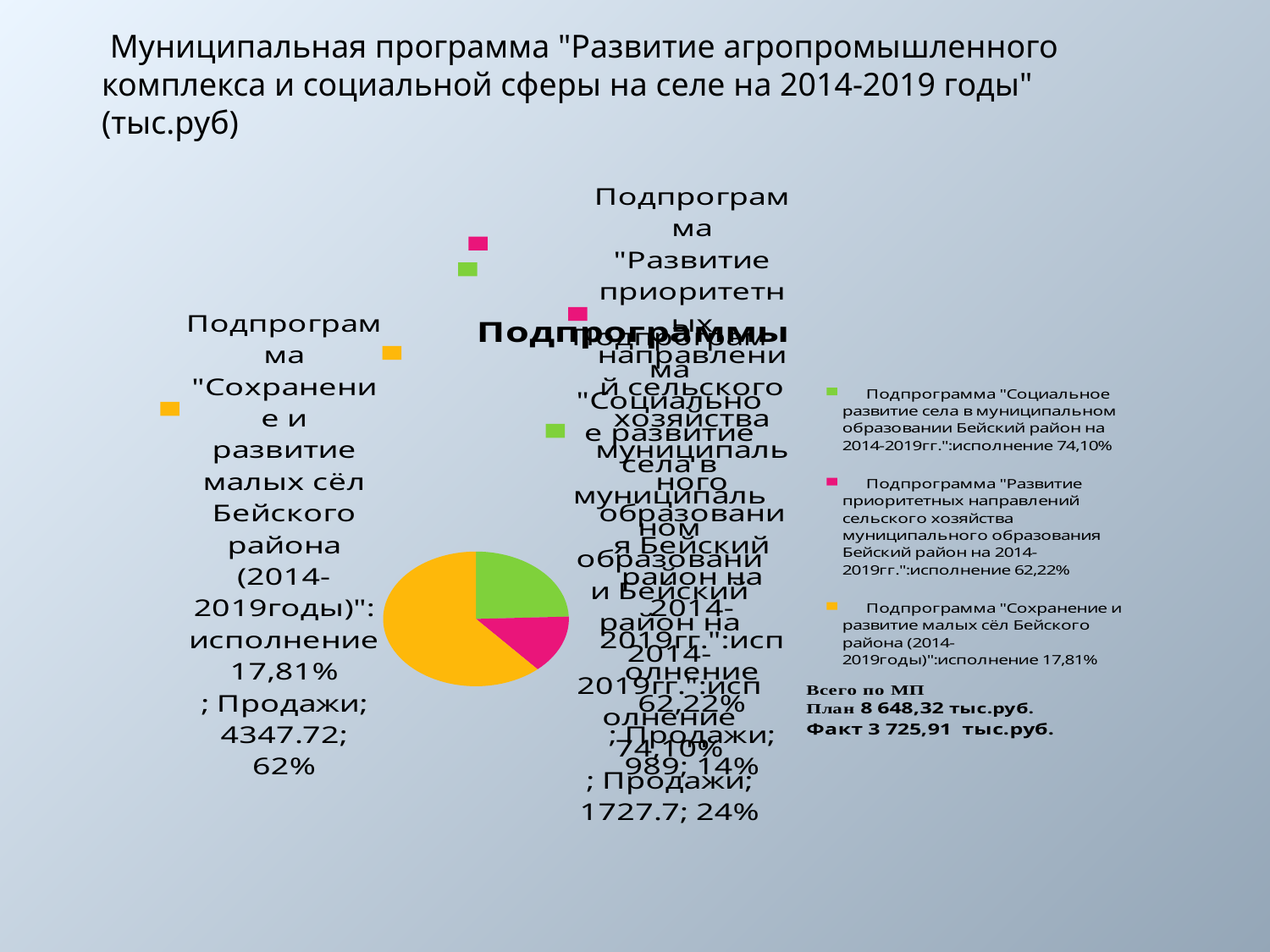
Which subprogram has the largest slice of the pie? Сохранение и развитие малых сёл Бейского района What kind of chart is shown on the slide? Pie chart What is the title of the pie chart? Подпрограммы What share of the pie does the subprogram "Развитие приоритетных направлений сельского хозяйства" take? 14% Which subprogram has the smallest slice of the pie? Развитие приоритетных направлений сельского хозяйства How many slices does the pie chart have? 3 What share of the pie does the subprogram "Сохранение и развитие малых сёл Бейского района" take? 62% How many entries does the legend list? 3 What value is shown for the subprogram "Социальное развитие села в муниципальном образовании Бейский район"? 1727.7 Which is larger: the value for "Социальное развитие села" or the value for "Развитие приоритетных направлений сельского хозяйства"? Социальное развитие села What value is shown for the subprogram "Сохранение и развитие малых сёл Бейского района"? 4347.72 What colour is the slice for the subprogram "Сохранение и развитие малых сёл Бейского района"? Yellow